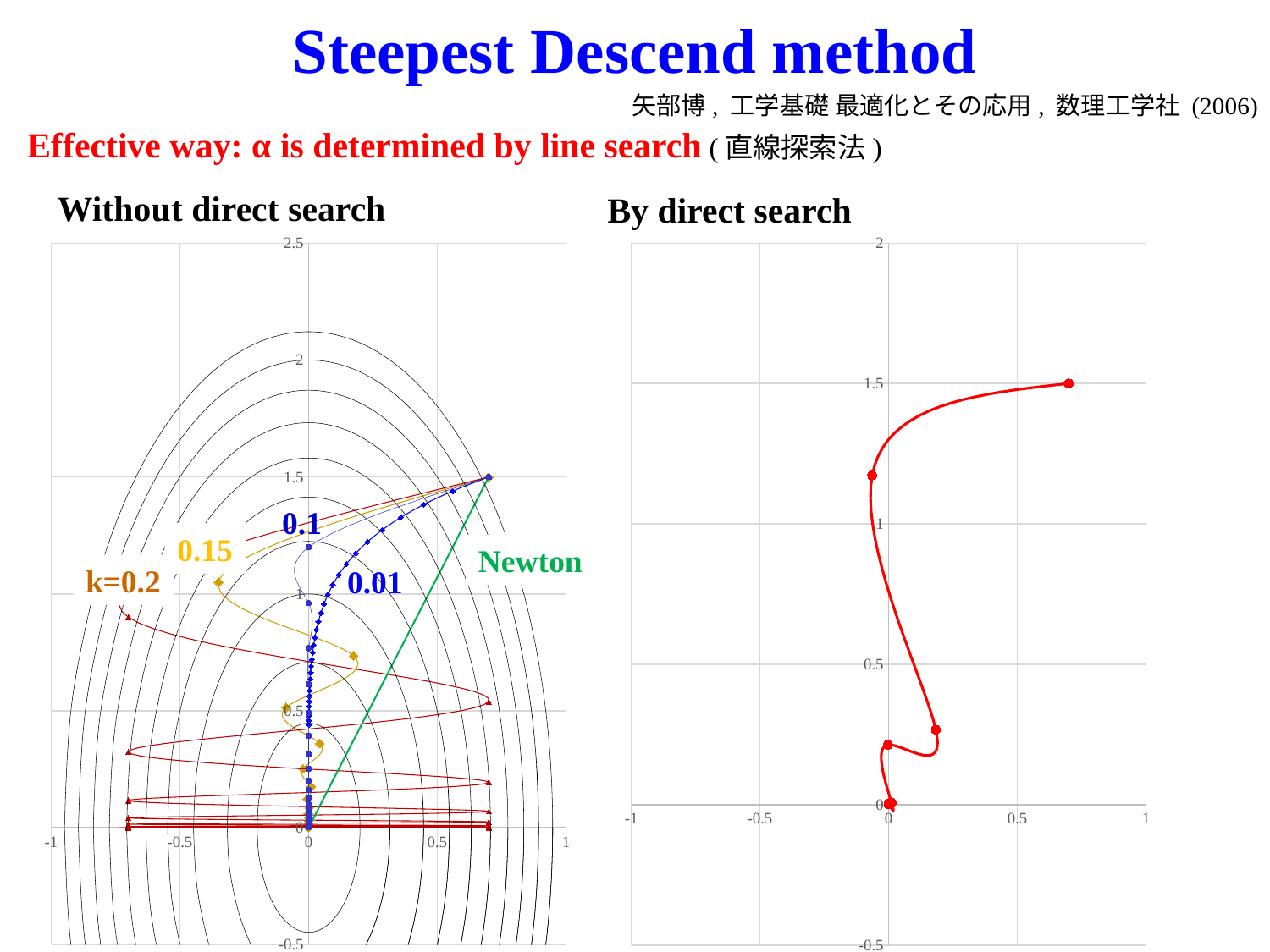
On the "Without direct search" chart, is the vertical value of the common starting point of the paths greater or less than 1? greater On the "Without direct search" chart, what is the lowest tick shown on the horizontal axis? -1 On the "By direct search" chart, is the vertical value of the starting point (rightmost marker) greater or less than 1? greater On the "Without direct search" chart, which path is drawn in green? Newton On the "Without direct search" chart, how many labeled paths are drawn? 5 On the "Without direct search" chart, what is the highest tick shown on the vertical axis? 2.5 On the "Without direct search" chart, which labeled path is drawn as a single straight line from the start to the minimum? Newton On the "By direct search" chart, what is the highest tick shown on the vertical axis? 2 What kind of chart is the "By direct search" chart on the right? line chart On the "By direct search" chart, what is the lowest tick shown on the vertical axis? -0.5 On the "By direct search" chart, is the vertical value of the final point of the path greater or less than 0.5? less